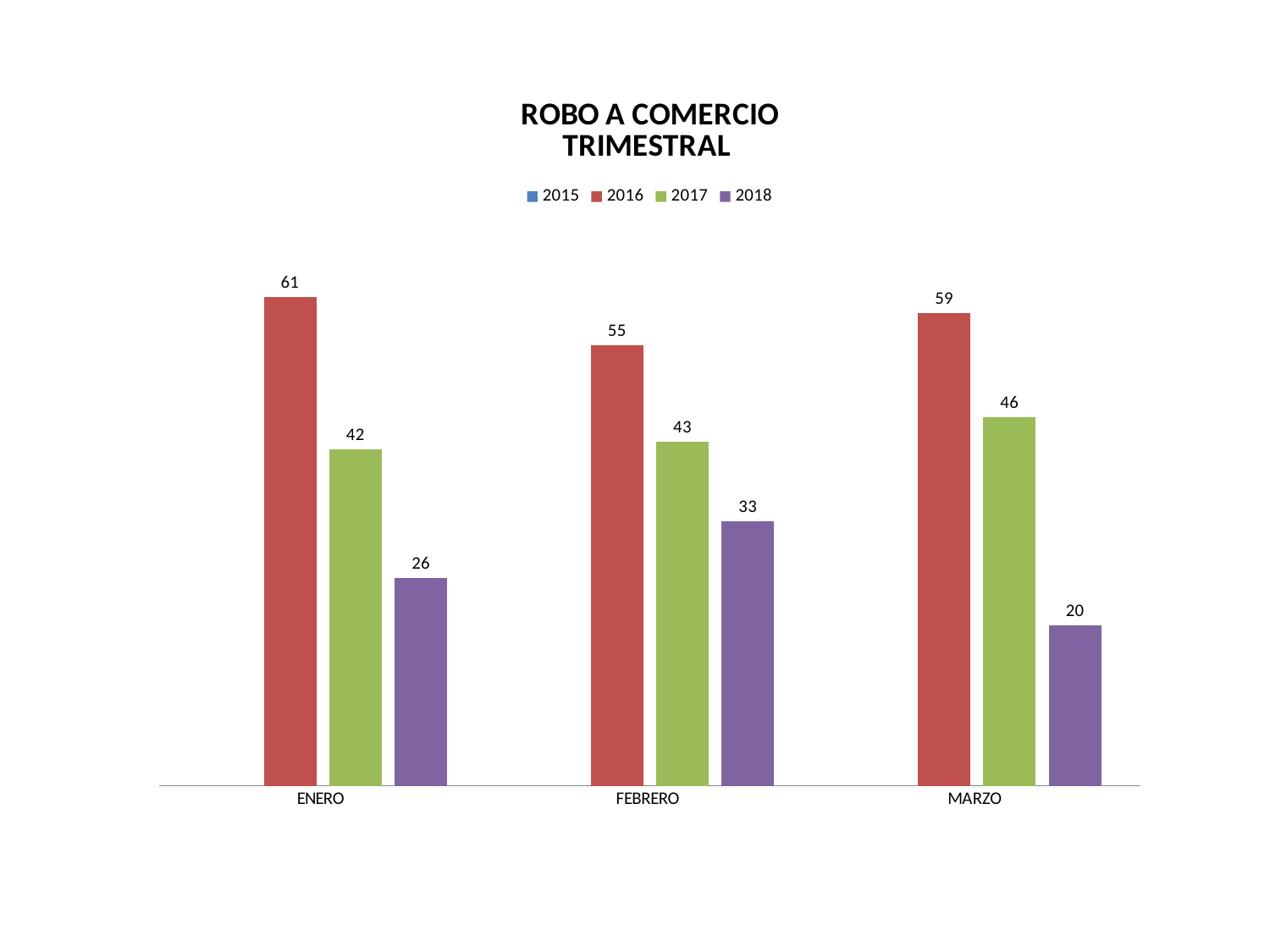
What is the difference between the 2016 and 2018 values in ENERO? 35 Do the 2018 values rise or fall from FEBRERO to MARZO? Fall Which month has the highest value for 2018? FEBRERO What is the value for 2016 in ENERO? 61 What kind of chart is shown? Bar chart Which is larger, the 2017 value in MARZO or the 2017 value in ENERO? MARZO How many series does the legend list? 4 How many months are shown on the x axis? 3 Which month has the lowest value for 2016? FEBRERO What is the value for 2017 in FEBRERO? 43 What is the title of the chart? ROBO A COMERCIO TRIMESTRAL What is the value for 2018 in MARZO? 20